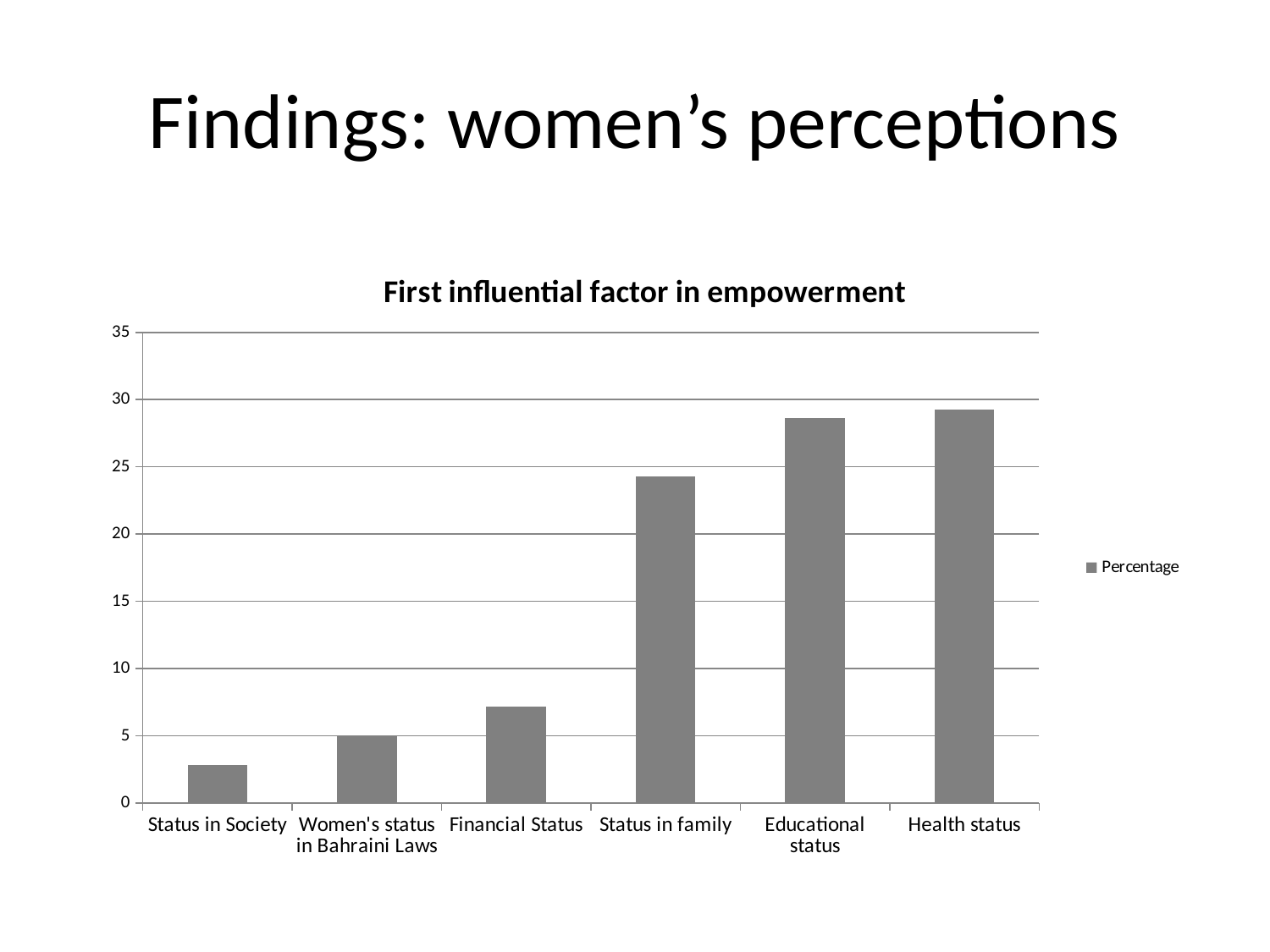
Is the value for Educational status greater or less than 25? greater How many series does the chart's legend list? 1 What is the name of the series shown in the legend? Percentage What type of chart is shown on the slide? bar chart What is the title of the chart? First influential factor in empowerment Is the value for Status in family greater or less than 20? greater Which is larger, the value for Educational status or the value for Status in family? Educational status How many categories are shown on the x axis of the chart? 6 Which is larger, the value for Status in family or the value for Financial Status? Status in family Is the value for Financial Status greater or less than 10? less Which category has the lowest value in the chart? Status in Society